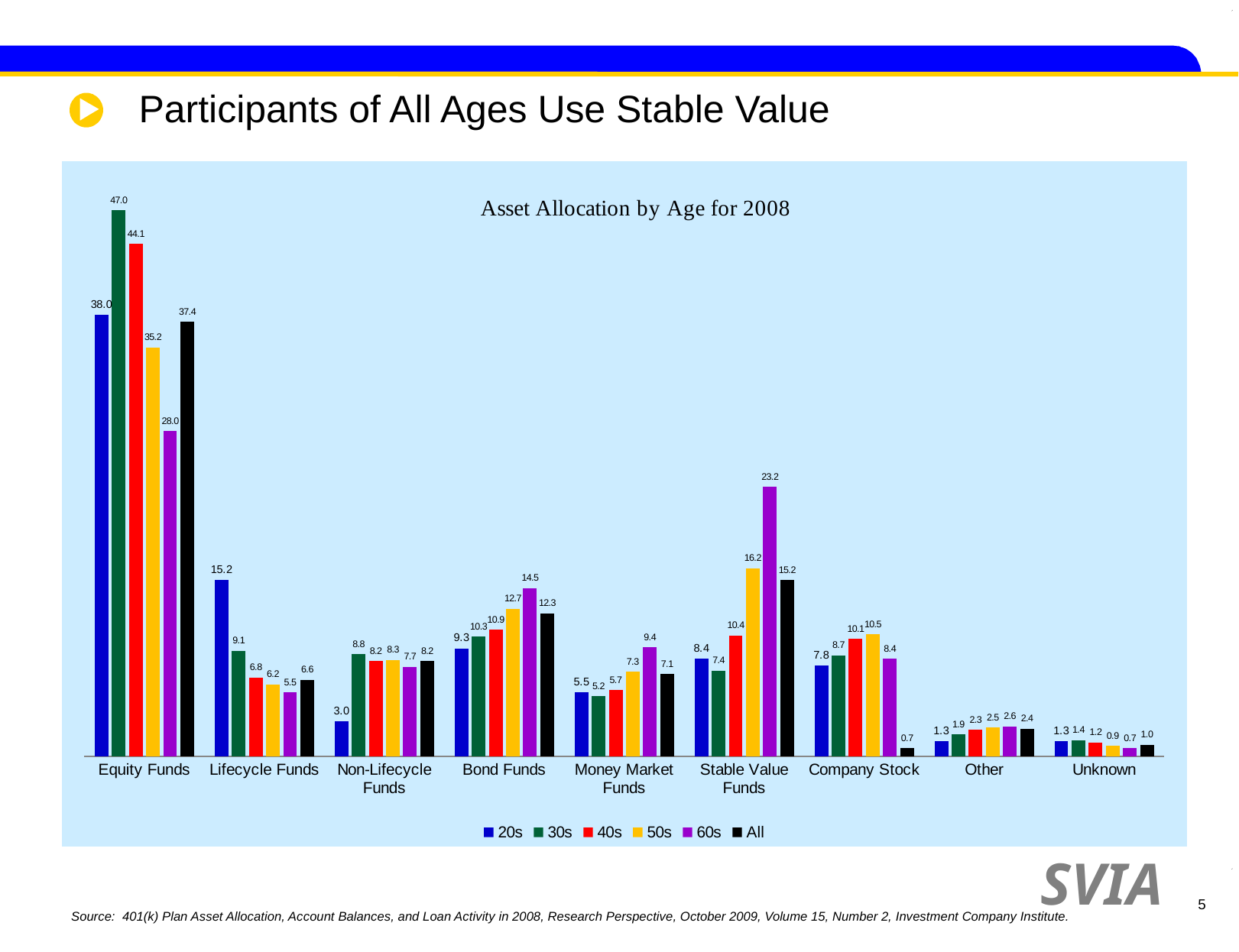
What is the value for the All series in the Bond Funds category? 12.3 Which age series has the lowest value in the Non-Lifecycle Funds category? 20s How many series does the legend list? 6 What kind of chart is shown on the slide? Bar chart Do the values for the 60s series rise or fall from Equity Funds to Stable Value Funds? Fall What is the title of the chart? Asset Allocation by Age for 2008 What is the difference between the 60s and 20s values in the Stable Value Funds category? 14.8 What is the value for the 60s series in the Stable Value Funds category? 23.2 What is the value for the 20s series in the Equity Funds category? 38.0 How many fund categories are shown on the x axis? 9 Which age series has the highest value in the Equity Funds category? 30s In the Lifecycle Funds category, which is larger: the 20s value or the 30s value? 20s